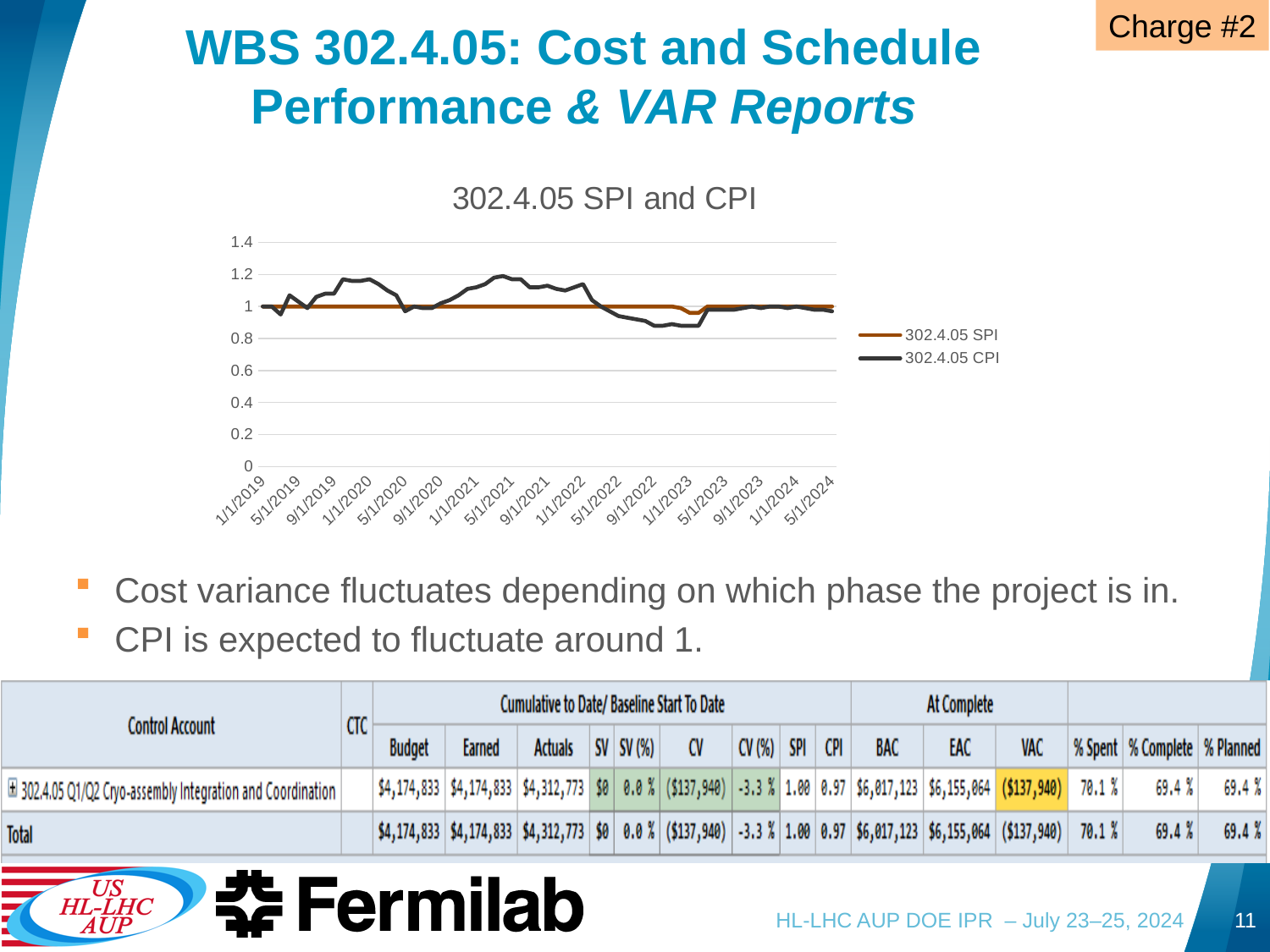
What are the two series named in the legend of the "302.4.05 SPI and CPI" chart? 302.4.05 SPI and 302.4.05 CPI In the "302.4.05 SPI and CPI" chart, is the 302.4.05 CPI value at 5/1/2021 greater or less than 1.4? less In the "302.4.05 SPI and CPI" chart, is the 302.4.05 CPI value at 5/1/2021 greater or less than 1? greater In the "302.4.05 SPI and CPI" chart, which series is larger at 5/1/2021, 302.4.05 SPI or 302.4.05 CPI? 302.4.05 CPI In the "302.4.05 SPI and CPI" chart, is the 302.4.05 CPI value at 1/1/2023 greater or less than 1? less In the "302.4.05 SPI and CPI" chart, which series is larger at 1/1/2023, 302.4.05 SPI or 302.4.05 CPI? 302.4.05 SPI How many series does the legend of the "302.4.05 SPI and CPI" chart list? 2 What is the highest value shown on the y axis of the "302.4.05 SPI and CPI" chart? 1.4 How many date labels are shown along the x axis of the "302.4.05 SPI and CPI" chart? 17 What is the first date label on the x axis of the "302.4.05 SPI and CPI" chart? 1/1/2019 What kind of chart is shown under the title "302.4.05 SPI and CPI"? line chart